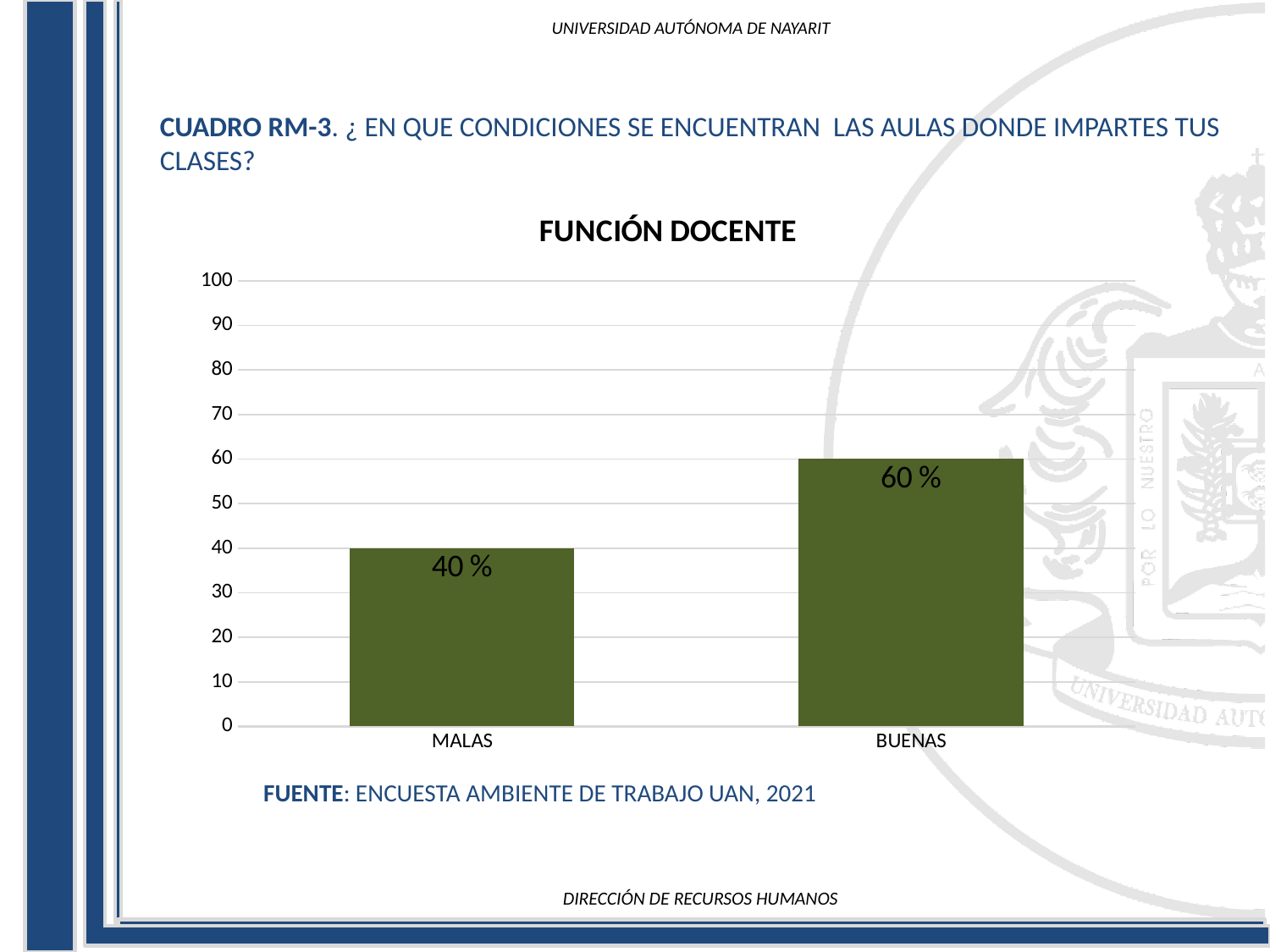
Is the value for MALAS greater or less than 50? less Is the value for BUENAS greater or less than 50? greater What is the value for MALAS? 40 % What kind of chart is shown on the slide? bar chart What is the title of the chart? FUNCIÓN DOCENTE What is the difference between the values for BUENAS and MALAS? 20 % Which is larger, the value for MALAS or the value for BUENAS? BUENAS Which category has the lowest value? MALAS How many categories are shown on the x axis? 2 Which category has the highest value? BUENAS What is the value for BUENAS? 60 % What is the maximum value shown on the vertical axis? 100